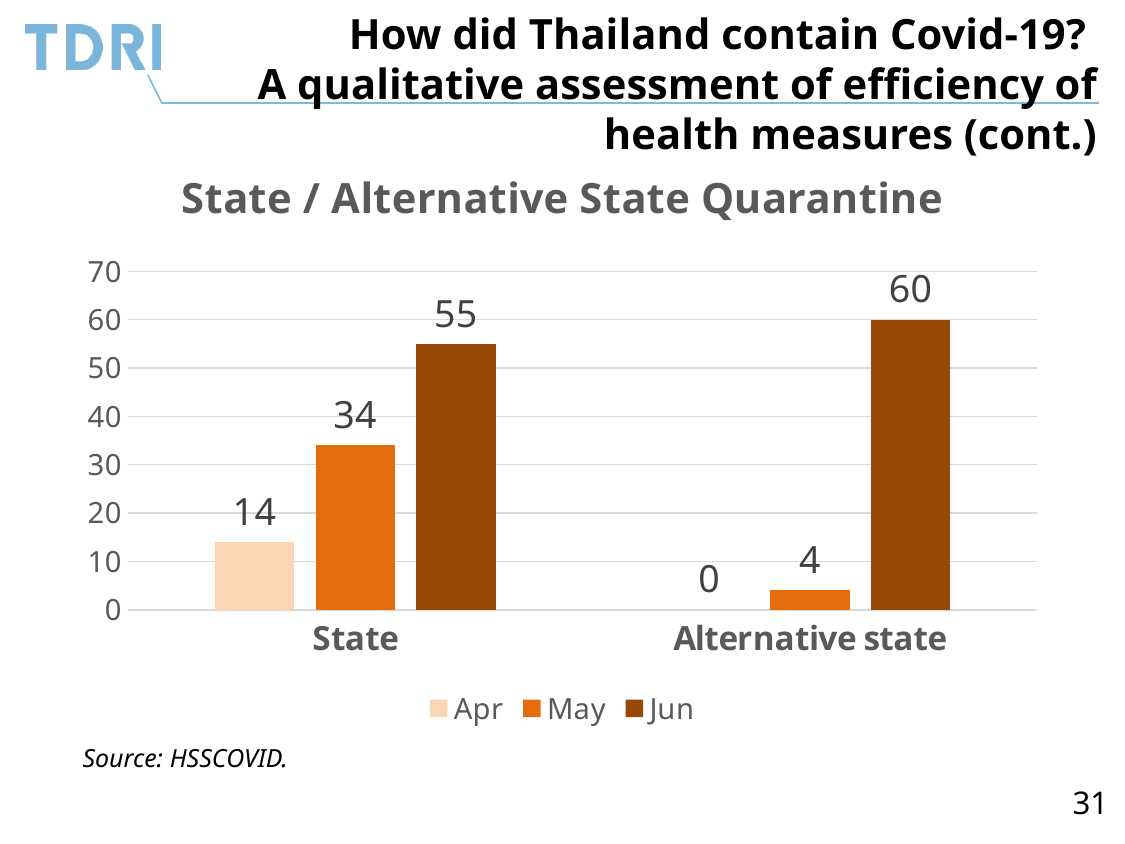
What is the value for May in the Alternative state category? 4 What is the value for Apr in the Alternative state category? 0 What is the difference between the May and Apr values for State? 20 What is the title of the chart? State / Alternative State Quarantine What kind of chart is shown? Bar chart What is the value for May in the State category? 34 How many series does the legend list? 3 Which category has the highest Jun value? Alternative state Which is larger, the Apr value for State or the May value for Alternative state? Apr value for State What is the difference between the Jun values for Alternative state and State? 5 Which category has the lowest May value? Alternative state What is the value for Jun in the State category? 55